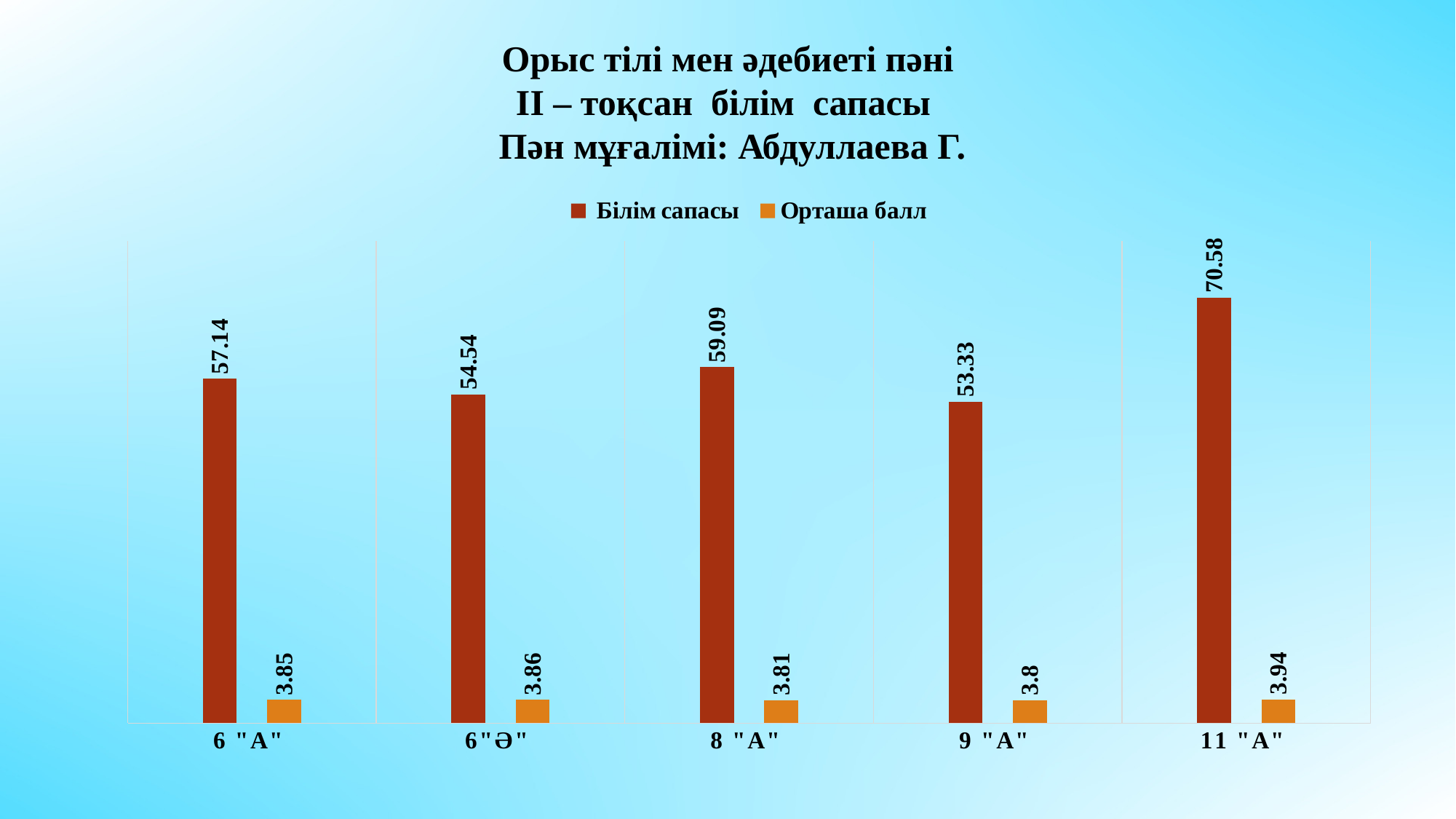
What is the Орташа балл value for 11 "А"? 3.94 What is the difference between the Орташа балл values for 11 "А" and 8 "А"? 0.13 What is the Білім сапасы value for 8 "А"? 59.09 What is the difference between the Білім сапасы values for 11 "А" and 9 "А"? 17.25 What is the Білім сапасы value for 6 "А"? 57.14 What kind of chart is shown on the slide? Bar chart Which class has the lowest Білім сапасы value? 9 "А" Which is larger, the Білім сапасы value for 6 "А" or for 6"Ә"? 6 "А" How many classes are shown on the x axis? 5 Which class has the highest Білім сапасы value? 11 "А" How many series does the legend list? 2 What is the Орташа балл value for 9 "А"? 3.8